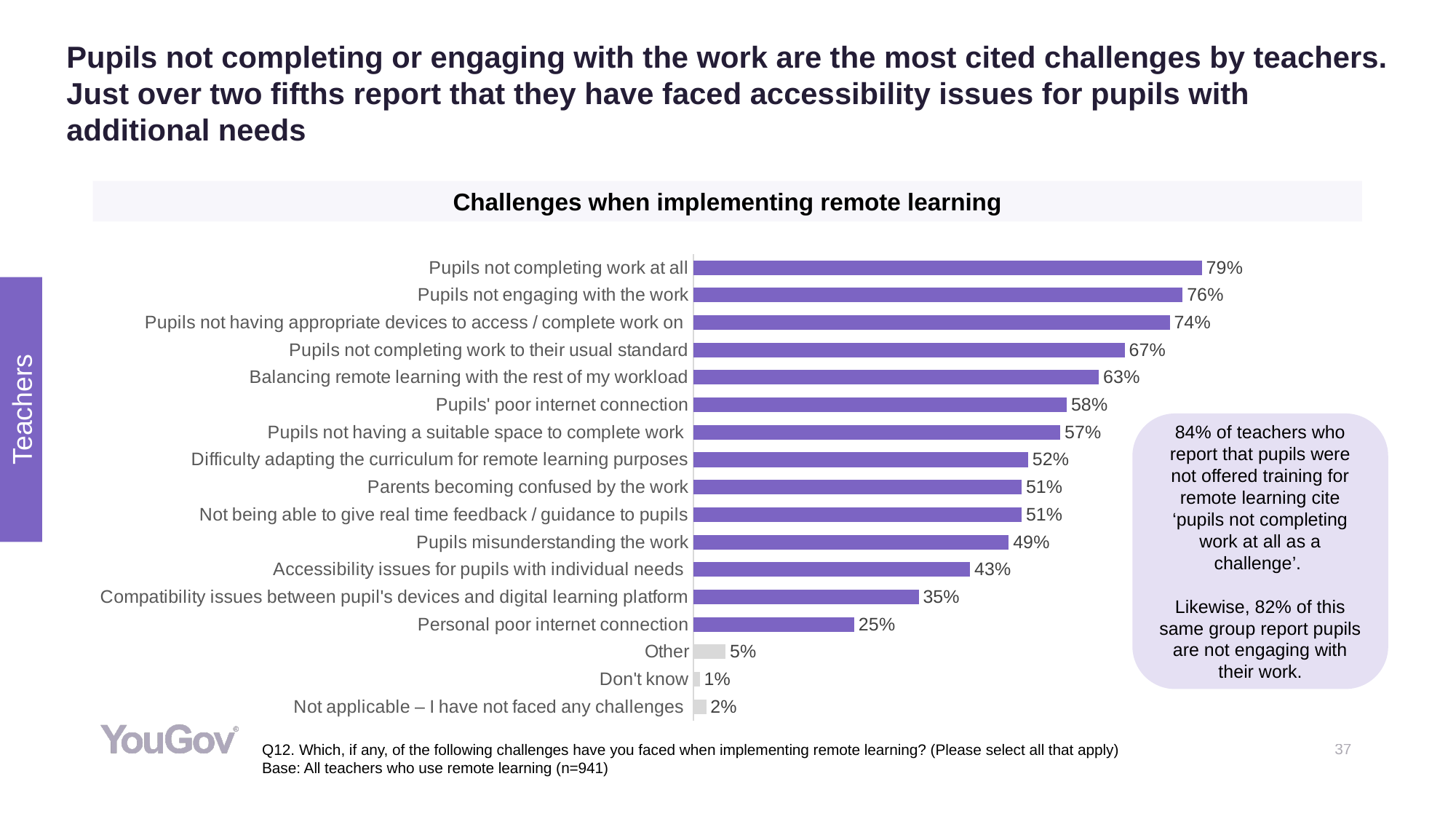
Which is larger: 'Balancing remote learning with the rest of my workload' or 'Pupils not having a suitable space to complete work'? Balancing remote learning with the rest of my workload What is the difference between 'Pupils not completing work at all' and 'Pupils not engaging with the work'? 3% Which challenge has the highest percentage in the chart? Pupils not completing work at all What is the value for 'Compatibility issues between pupil's devices and digital learning platform'? 35% What percentage of teachers cite 'Pupils not completing work at all' as a challenge? 79% How many categories are shown in the chart? 17 What is the difference between 'Pupils' poor internet connection' and 'Personal poor internet connection'? 33% What percentage of teachers report 'Personal poor internet connection' as a challenge? 25% What is the value for 'Accessibility issues for pupils with individual needs'? 43% Which category has the lowest value in the chart? Don't know What is the title of the chart? Challenges when implementing remote learning What type of chart is shown on the slide? Bar chart